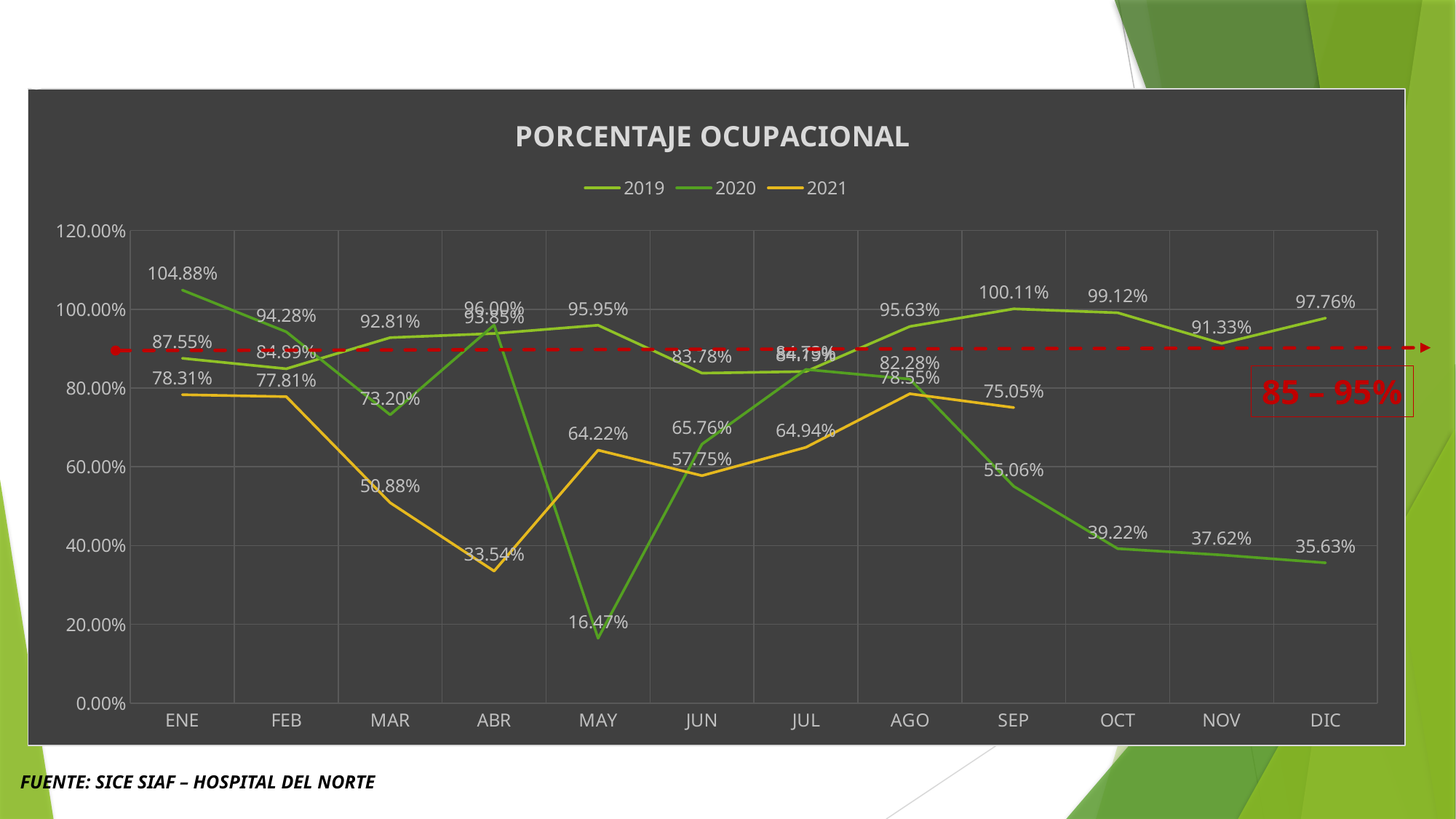
Do the 2020 values rise or fall from SEP to DIC? fall What kind of chart is shown on the slide? line chart What is the value for 2019 in SEP? 100.11% Which is larger in ENE, the 2019 value or the 2020 value? 2020 What is the title of the chart? PORCENTAJE OCUPACIONAL In which month does the 2020 series reach its highest value? ENE How many months are shown on the x axis? 12 How many series does the legend list? 3 What is the difference between the 2020 values in ENE and DIC? 69.25% In which month does the 2020 series reach its lowest value? MAY What is the value for 2020 in MAY? 16.47% What is the value for 2021 in ABR? 33.54%